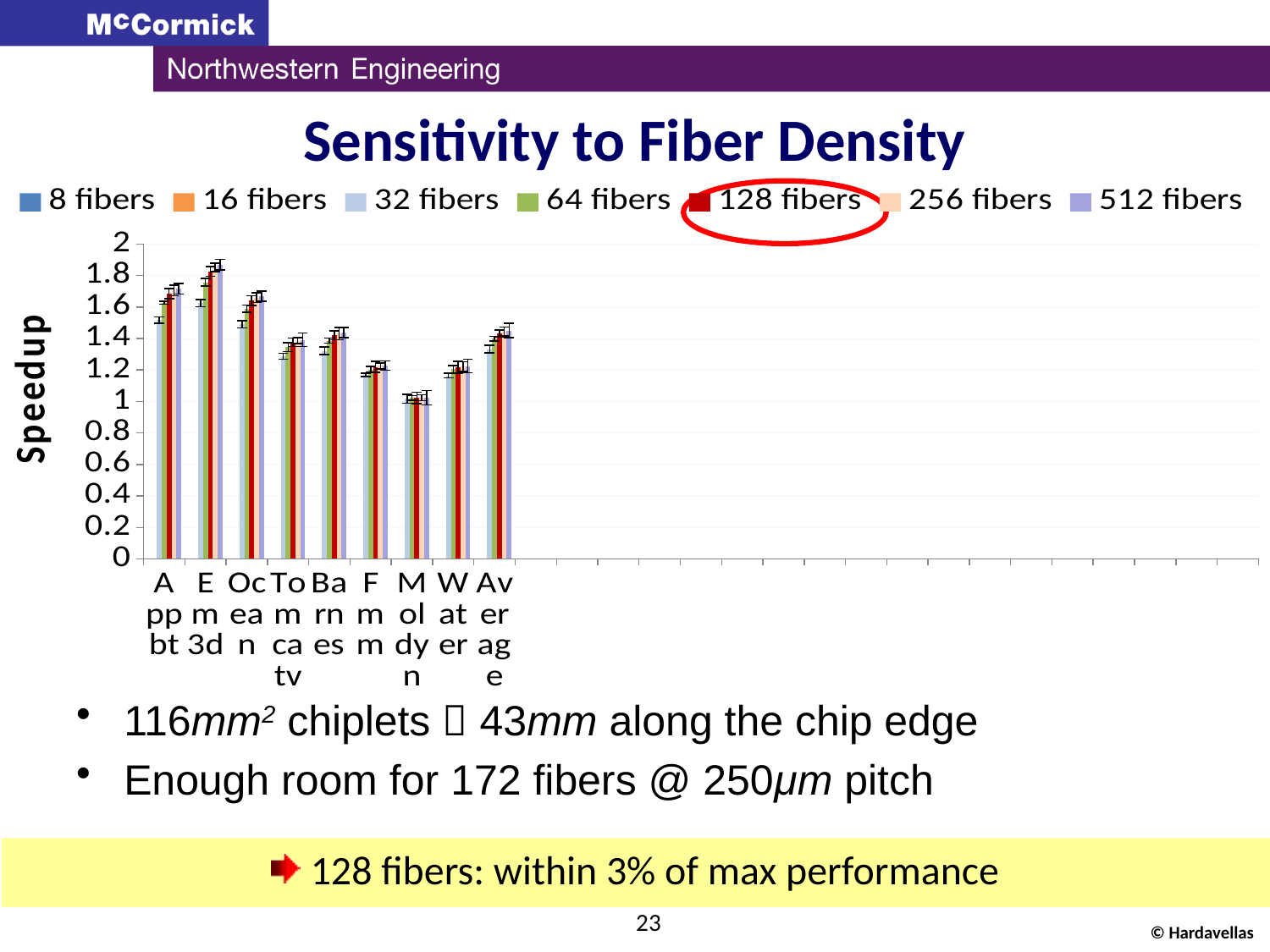
Which has the larger speedup with 128 fibers, Tomcatv or Water? Tomcatv How many series does the chart legend list? 7 Which benchmark has the highest speedup bars? Em3d How many benchmark categories are plotted along the x axis? 9 Is the speedup for Appbt with 128 fibers greater or less than 1.4? greater Is the speedup for Fmm with 512 fibers greater or less than 1.4? less Which has the larger speedup with 128 fibers, Em3d or Moldyn? Em3d What is the title of the chart? Sensitivity to Fiber Density Which legend entry is circled in red? 128 fibers Which benchmark has the lowest speedup bars? Moldyn Is the speedup for Moldyn with 128 fibers greater or less than 1.2? less What kind of chart is shown on the slide? bar chart